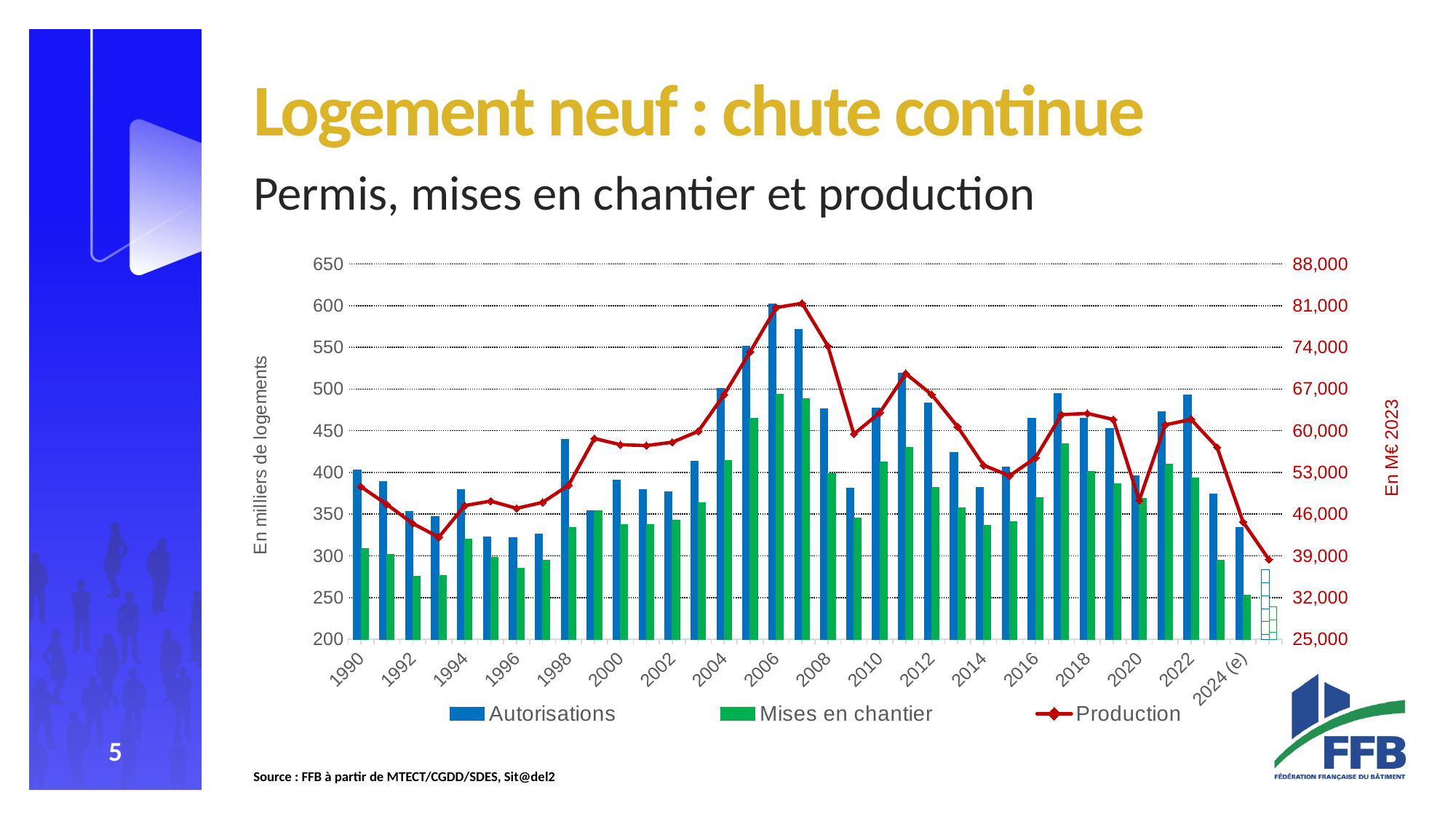
Is the value of Production in 2024 (e) greater or less than 46,000? less Is the value of Production in 2007 greater or less than 74,000? greater Which series is drawn as a red line in the chart? Production Is the value of Mises en chantier in 1992 greater or less than 300? less Does the Production line rise or fall between 2022 and 2024 (e)? It falls In 2006, which is larger: Autorisations or Mises en chantier? Autorisations What is the label of the left vertical axis of the chart? En milliers de logements How many series does the chart legend list? 3 In which year do the Autorisations bars reach their highest value? 2006 Do the Autorisations bars rise or fall from 2003 to 2006? They rise What kind of chart is shown on the slide? A combined bar and line chart